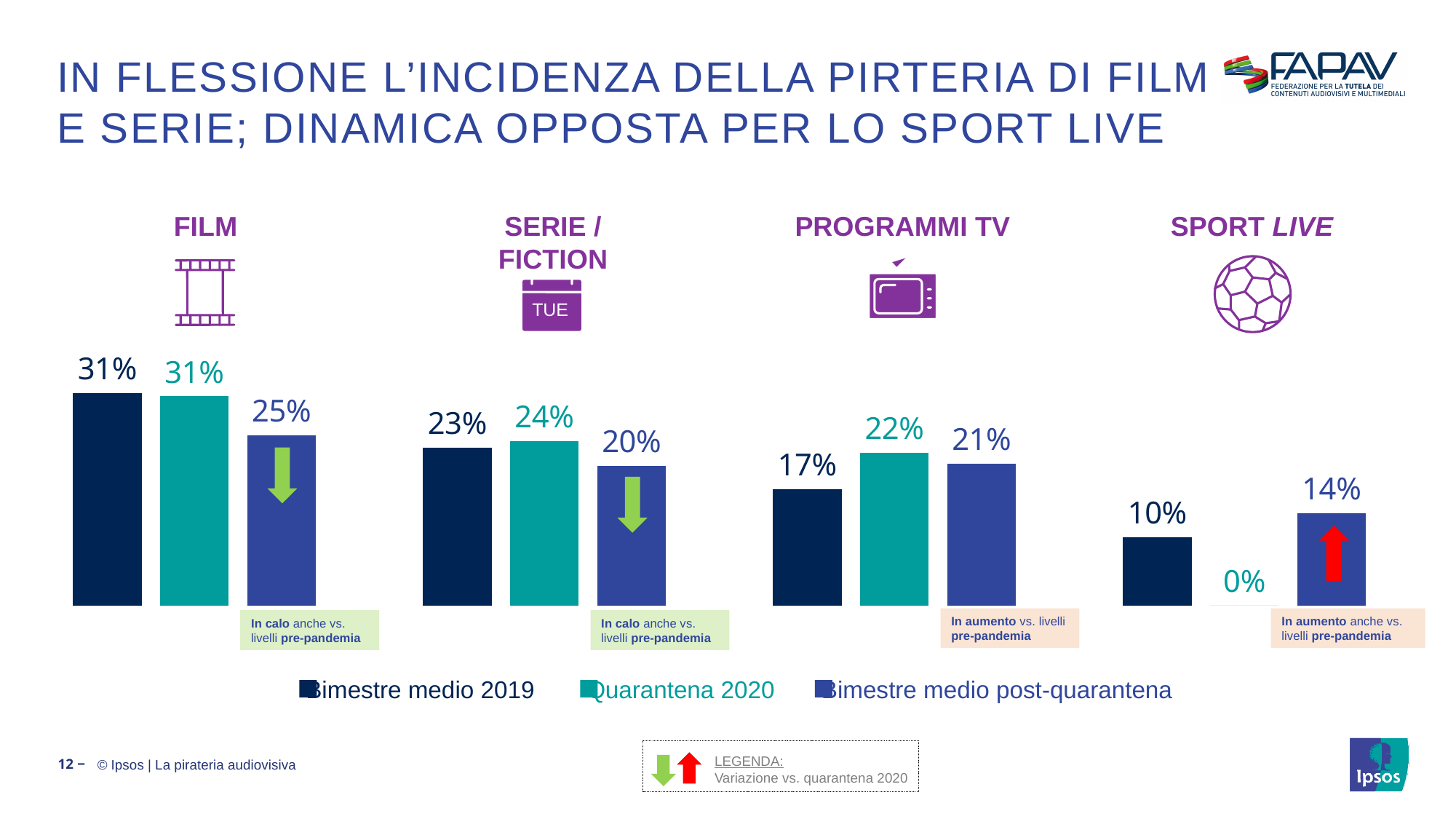
What is the difference between the Quarantena 2020 and Bimestre medio post-quarantena values for FILM? 6% Which category has the highest value in the Bimestre medio post-quarantena series? FILM What is the difference between the Bimestre medio post-quarantena and Bimestre medio 2019 values for SPORT LIVE? 4% What kind of chart is shown on the slide? Bar chart What is the value for FILM in the Bimestre medio 2019 series? 31% What is the value for PROGRAMMI TV in the Bimestre medio post-quarantena series? 21% What is the value for SERIE / FICTION in the Quarantena 2020 series? 24% What is the value for SPORT LIVE in the Quarantena 2020 series? 0% Which category has the lowest value in the Bimestre medio 2019 series? SPORT LIVE How many series does the legend list? 3 Which is larger for PROGRAMMI TV: the Bimestre medio 2019 value or the Quarantena 2020 value? Quarantena 2020 How many categories are shown in the chart? 4